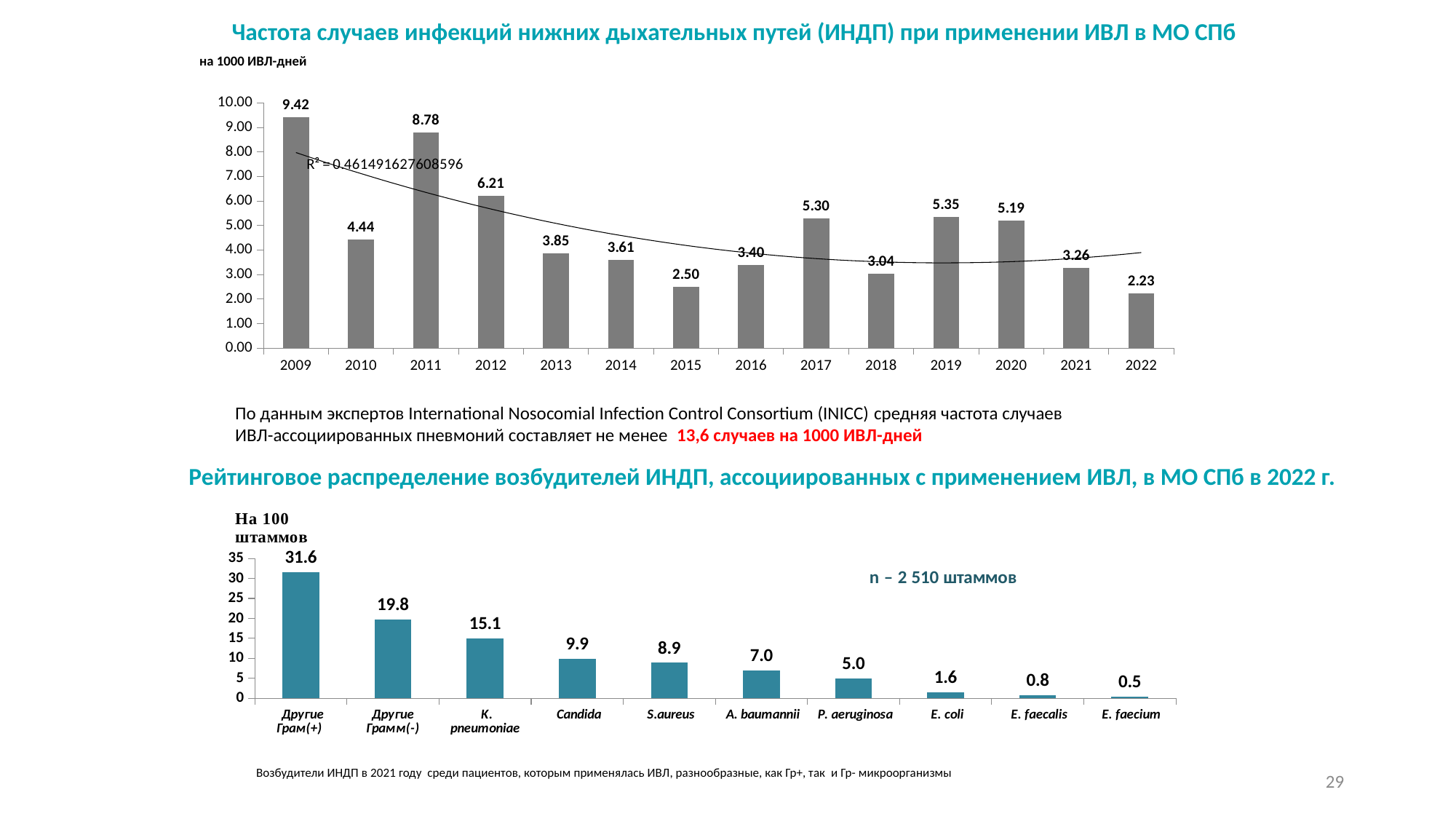
In the top chart (Частота случаев ИНДП при применении ИВЛ), what is the difference between the values for 2011 and 2012? 2.57 In the bottom chart (Рейтинговое распределение возбудителей ИНДП), how many categories are shown? 10 In the top chart (Частота случаев ИНДП при применении ИВЛ), what is the value for 2009? 9.42 In the bottom chart (Рейтинговое распределение возбудителей ИНДП), which category has the lowest value? E. faecium In the bottom chart (Рейтинговое распределение возбудителей ИНДП), which is larger: Candida or S.aureus? Candida What kind of chart is the bottom chart (Рейтинговое распределение возбудителей ИНДП)? bar chart In the bottom chart (Рейтинговое распределение возбудителей ИНДП), what is the value for K. pneumoniae? 15.1 In the top chart (Частота случаев ИНДП при применении ИВЛ), which year has the highest value? 2009 In the top chart (Частота случаев ИНДП при применении ИВЛ), how many years are shown on the x axis? 14 In the top chart (Частота случаев ИНДП при применении ИВЛ), which year has the lowest value? 2022 In the top chart (Частота случаев ИНДП при применении ИВЛ), do the values generally rise or fall from 2009 to 2022? fall In the top chart (Частота случаев ИНДП при применении ИВЛ), what is the value for 2022? 2.23